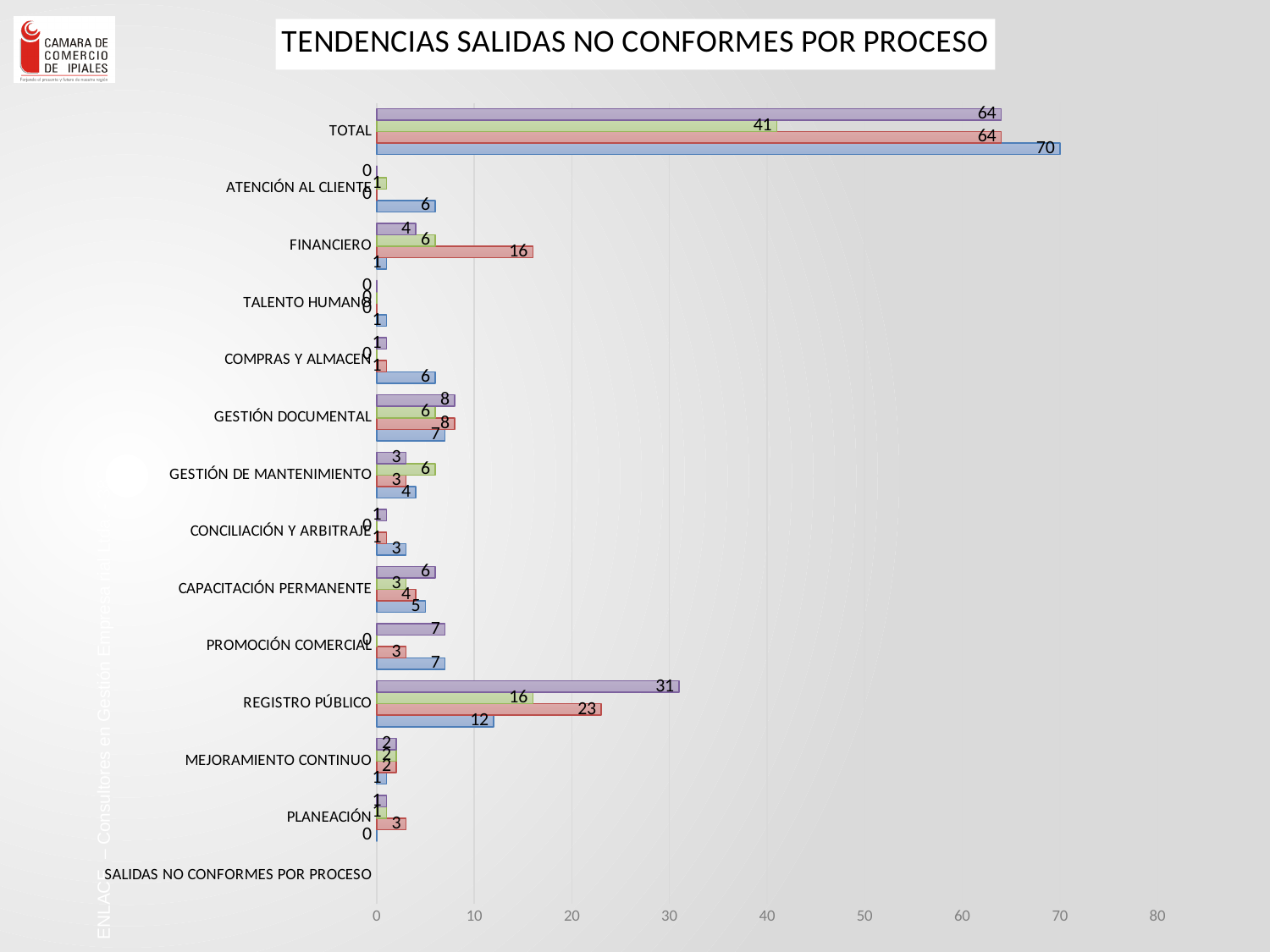
For FINANCIERO, which is larger: the red bar or the green bar? the red bar What is the value of the purple bar for REGISTRO PÚBLICO? 31 What type of chart is shown on the slide? bar chart Excluding TOTAL, which process has the highest purple bar? REGISTRO PÚBLICO What is the title of the chart? TENDENCIAS SALIDAS NO CONFORMES POR PROCESO Is the value of the blue bar for TOTAL greater or less than 60? greater What is the value of the green bar for TOTAL? 41 What is the difference between the blue bar for TOTAL and the green bar for TOTAL? 29 What is the value of the blue bar for TOTAL? 70 What is the difference between the red bar and the blue bar for REGISTRO PÚBLICO? 11 What is the value of the blue bar for GESTIÓN DOCUMENTAL? 7 What is the value of the red bar for FINANCIERO? 16